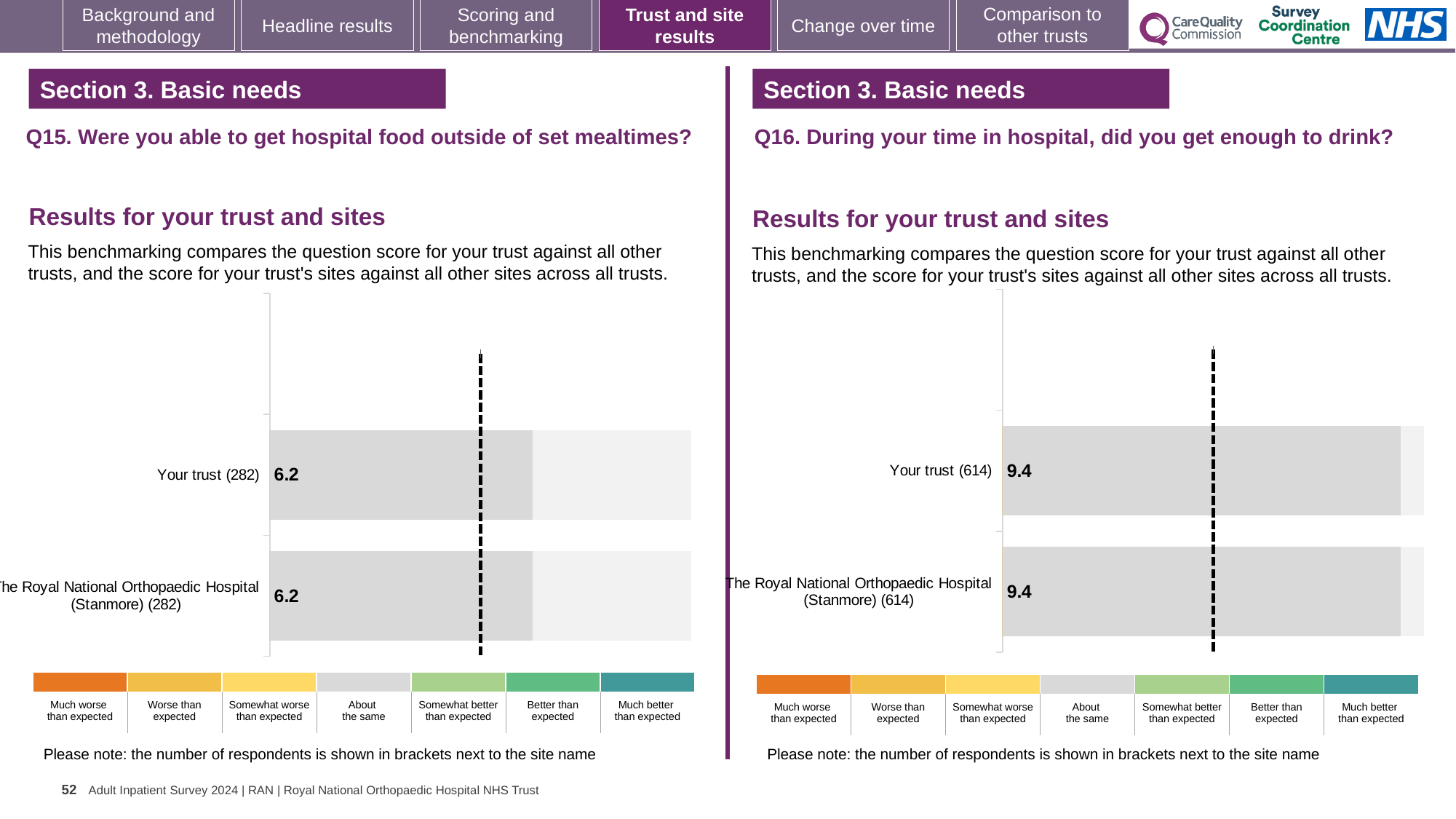
On the Q16 chart (right), what is the difference between the score for Your trust and the score for The Royal National Orthopaedic Hospital (Stanmore)? 0.0 On the Q15 chart (left), how many respondents are shown in brackets for Your trust? 282 On the Q15 chart (left), what is the score for Your trust? 6.2 Is the score for Your trust on the Q16 chart (right) larger or smaller than the score for Your trust on the Q15 chart (left)? Larger How many bars are plotted on the Q15 chart (left)? 2 On the Q15 chart (left), what is the score for The Royal National Orthopaedic Hospital (Stanmore)? 6.2 On the Q16 chart (right), what is the score for Your trust? 9.4 On the Q15 chart (left), what is the difference between the score for Your trust and the score for The Royal National Orthopaedic Hospital (Stanmore)? 0.0 On the Q16 chart (right), how many respondents are shown in brackets for The Royal National Orthopaedic Hospital (Stanmore)? 614 How many bars are plotted on the Q16 chart (right)? 2 What kind of chart is the Q16 chart (right)? Bar chart On the Q16 chart (right), what is the score for The Royal National Orthopaedic Hospital (Stanmore)? 9.4